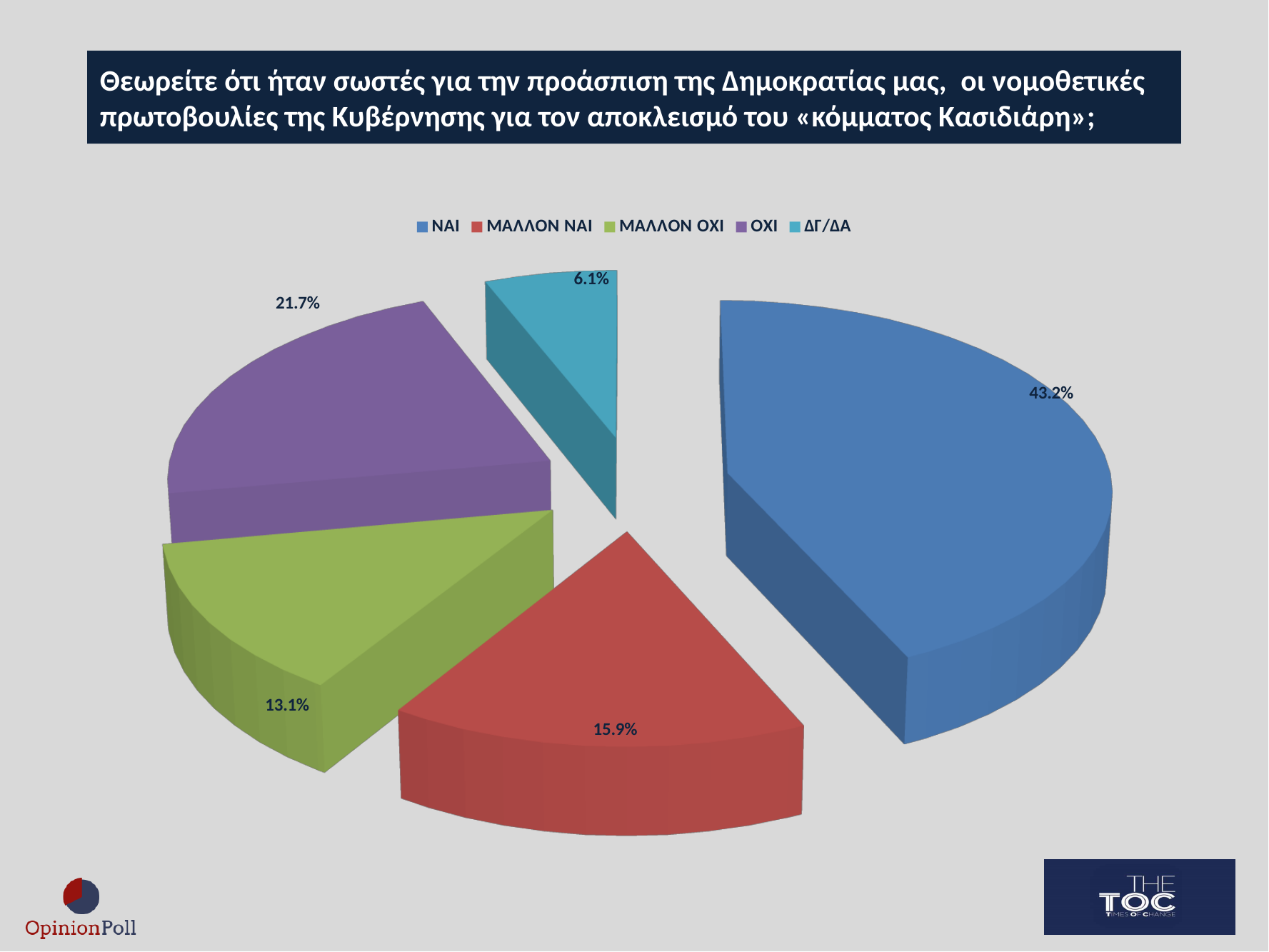
What colour is the slice for ΟΧΙ? purple What percentage is shown for ΝΑΙ? 43.2% What percentage is shown for ΟΧΙ? 21.7% Which category has the largest share of the pie? ΝΑΙ What percentage is shown for ΔΓ/ΔΑ? 6.1% What percentage is shown for ΜΑΛΛΟΝ ΟΧΙ? 13.1% What is the difference in percentage points between ΝΑΙ and ΟΧΙ? 21.5 Which category has the smallest share of the pie? ΔΓ/ΔΑ How many slices does the pie chart have? 5 Which is larger, the share for ΜΑΛΛΟΝ ΝΑΙ or the share for ΜΑΛΛΟΝ ΟΧΙ? ΜΑΛΛΟΝ ΝΑΙ What percentage is shown for ΜΑΛΛΟΝ ΝΑΙ? 15.9% What type of chart is shown on the slide? pie chart